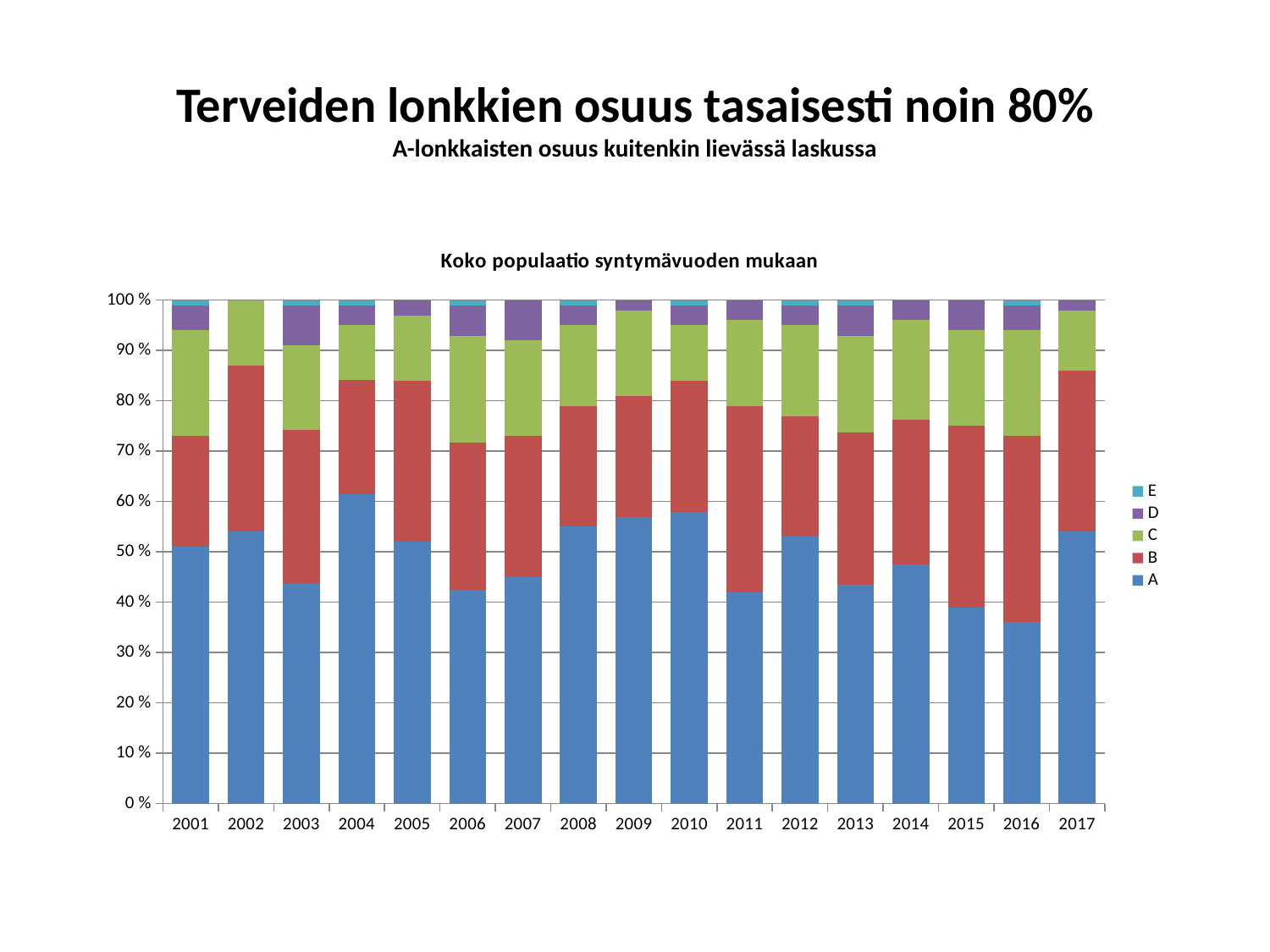
Which year has the lowest share for series A? 2016 Which year has a larger share for series A, 2004 or 2016? 2004 What kind of chart is shown on the slide? stacked bar chart Is the share of series A in 2004 greater or less than 50 %? greater How many series does the legend list? 5 Which series is shown in blue at the bottom of each bar? A How many years are shown on the x axis? 17 Which year has the highest share for series A? 2004 Is the share of series A in 2016 greater or less than 40 %? less Is the share of series A in 2006 greater or less than 50 %? less What is the title of the chart? Koko populaatio syntymävuoden mukaan Which year has a larger share for series A, 2009 or 2015? 2009